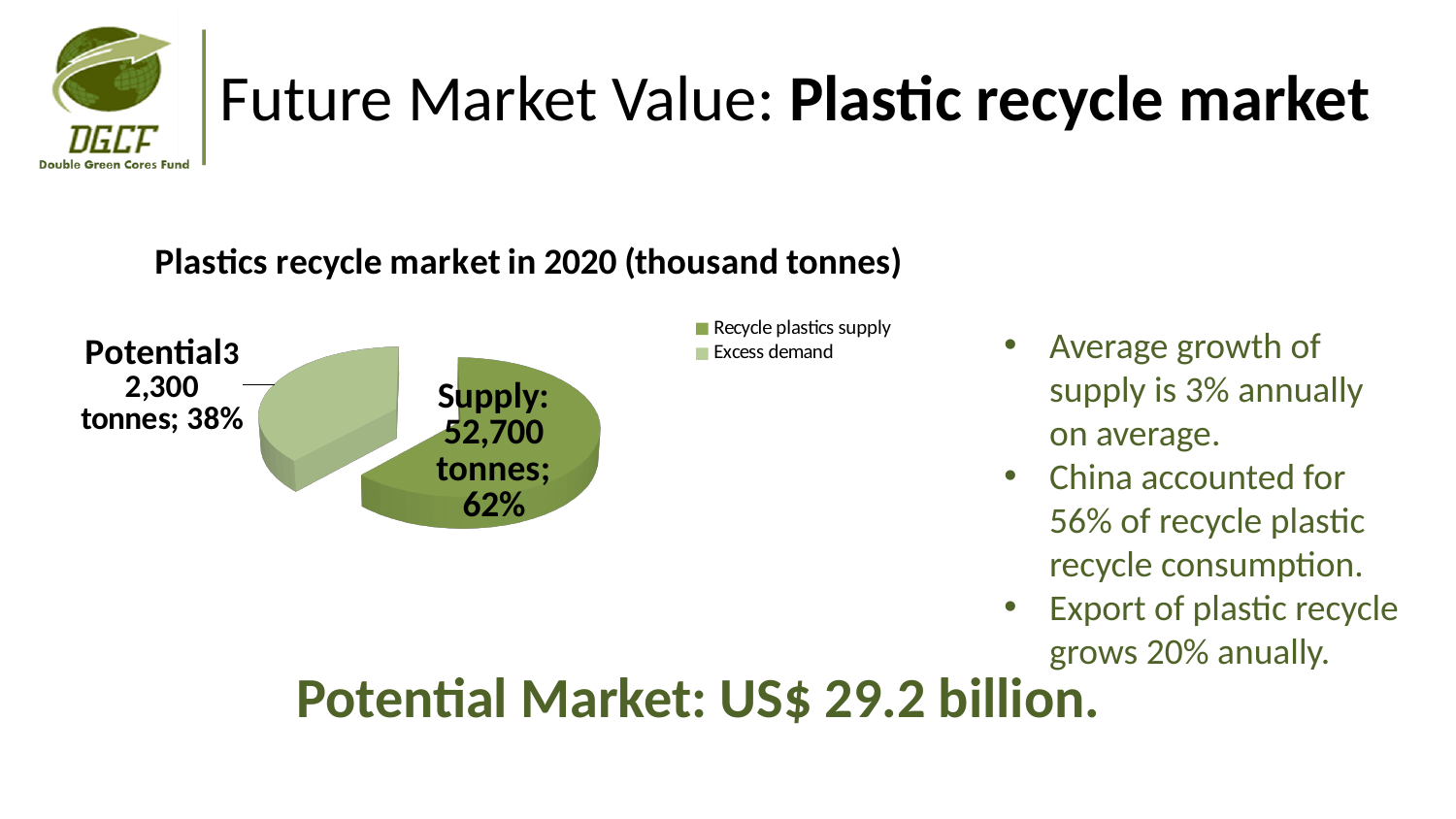
Which slice of the pie chart is the largest? Supply What share of the pie does the Potential slice represent? 38% What are the two entries listed in the chart legend? Recycle plastics supply; Excess demand How many slices does the pie chart have? 2 What kind of chart is shown on the slide? Pie chart How many entries does the chart legend list? 2 What is the value shown for the Supply slice of the pie chart? 52,700 tonnes What is the title of the chart? Plastics recycle market in 2020 (thousand tonnes) What share of the pie does the Supply slice represent? 62% Which is larger, the Supply slice or the Potential slice? Supply Which slice of the pie chart is the smallest? Potential By how many percentage points does the Supply share exceed the Potential share? 24 percentage points